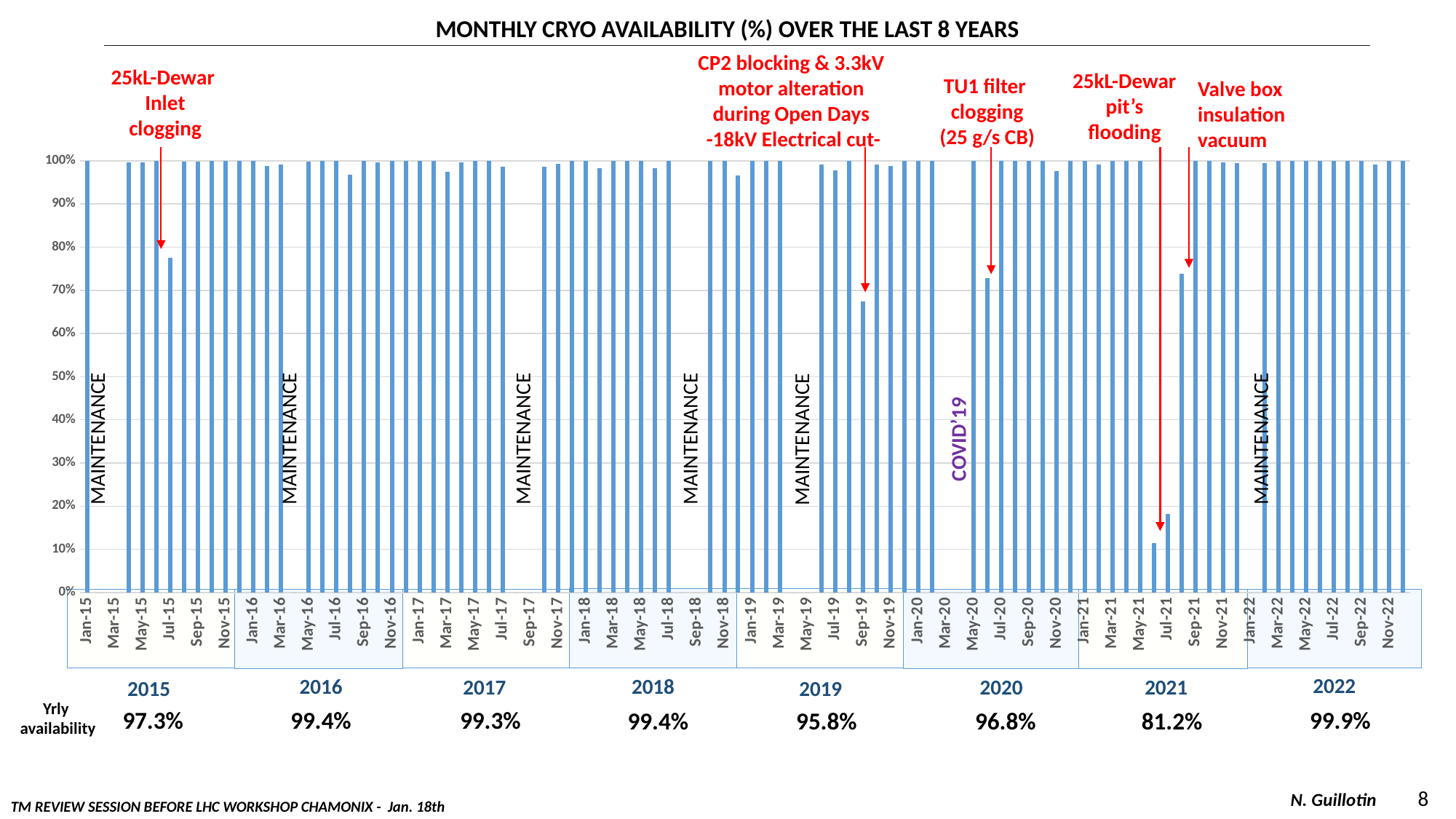
What kind of chart is shown on the slide? bar chart What event is annotated in red above the low bar in Jul-15? 25kL-Dewar Inlet clogging What is the difference between the yearly availability of 2022 and 2021? 18.7% What is the yearly availability shown for 2019? 95.8% How many years of yearly availability values are listed below the chart? 8 Is the monthly availability bar for Jun-21 greater or less than 20%? less What is the yearly availability shown for 2021? 81.2% What is the title of the chart? MONTHLY CRYO AVAILABILITY (%) OVER THE LAST 8 YEARS Which year has the higher yearly availability, 2015 or 2020? 2015 Which year has the highest yearly availability? 2022 Is the monthly availability bar for Sep-19 greater or less than 70%? less Which year has the lowest yearly availability? 2021